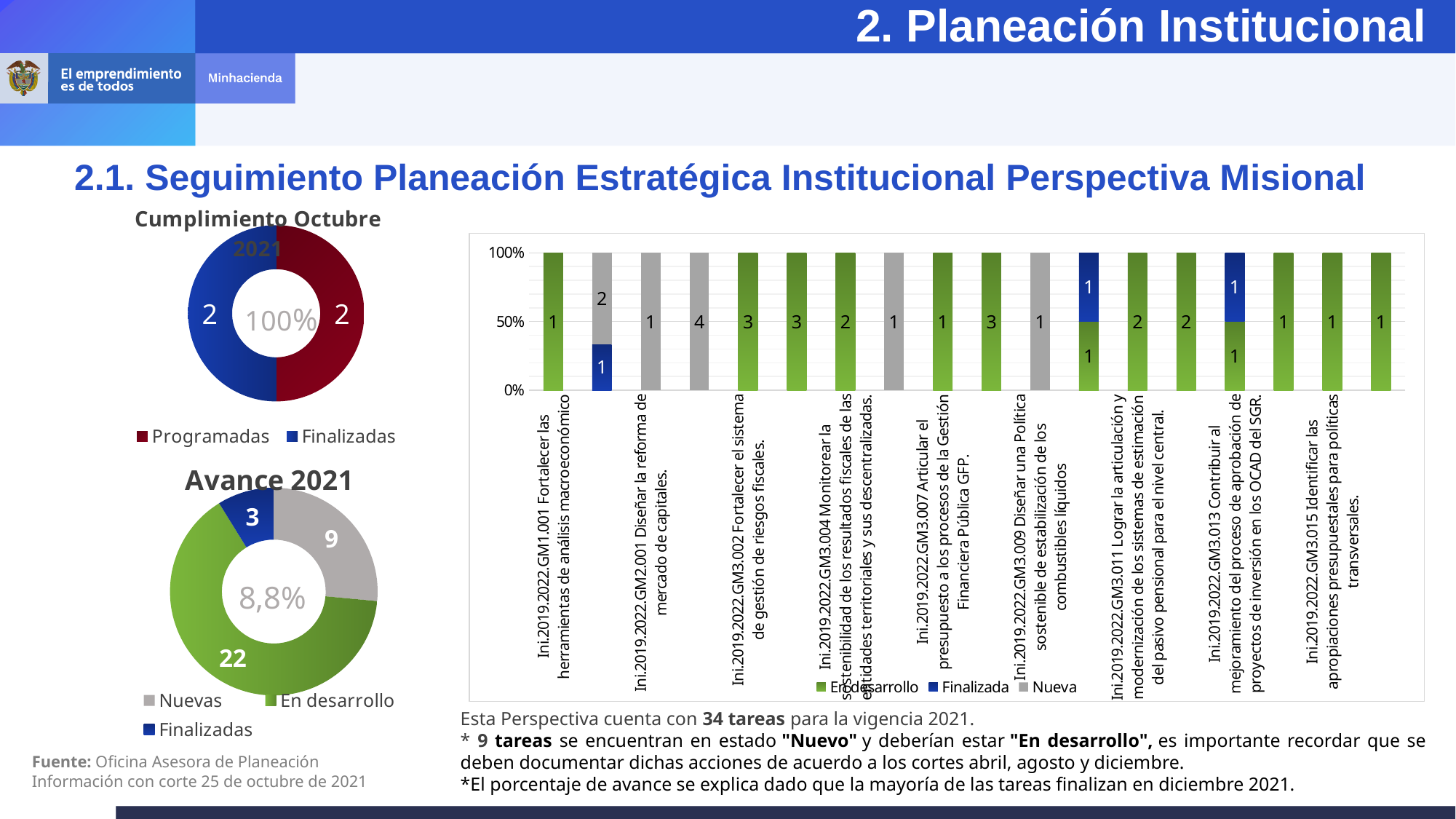
In the 'Avance 2021' chart, which category has the smallest slice? Finalizadas In the 'Avance 2021' chart, what is the value for Nuevas? 9 In the 'Avance 2021' chart, which category has the largest slice? En desarrollo In the 'Cumplimiento Octubre 2021' chart, what is the value for Programadas? 2 In the stacked bar chart on the right, how many series does the legend list? 3 In the stacked bar chart on the right, what is the Finalizada value for Ini.2019.2022.GM3.013 Contribuir al mejoramiento del proceso de aprobación de proyectos de inversión en los OCAD del SGR? 1 In the 'Cumplimiento Octubre 2021' chart, what percentage is shown in the centre of the doughnut? 100% In the 'Avance 2021' chart, what is the difference between the En desarrollo value and the Nuevas value? 13 In the 'Avance 2021' chart, what percentage is shown in the centre of the doughnut? 8,8% In the 'Avance 2021' chart, what is the value for En desarrollo? 22 In the stacked bar chart on the right, what is the En desarrollo value for Ini.2019.2022.GM3.002 Fortalecer el sistema de gestión de riesgos fiscales? 3 In the 'Avance 2021' chart, what kind of chart is it? Doughnut (pie) chart